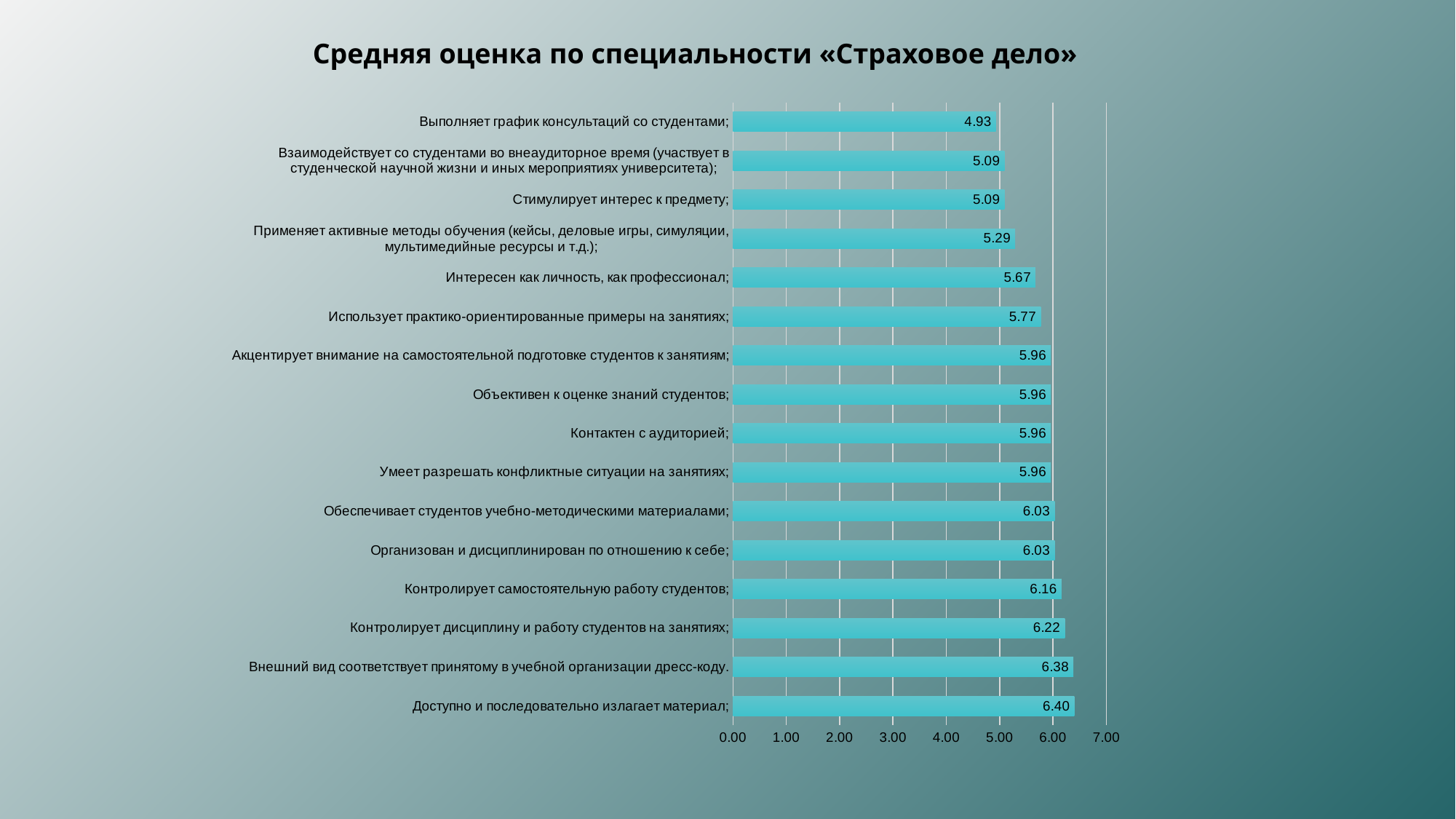
What type of chart is shown on the slide? Bar chart What is the value for «Контролирует дисциплину и работу студентов на занятиях»? 6.22 What is the title of the chart? Средняя оценка по специальности «Страховое дело» What is the value for «Интересен как личность, как профессионал»? 5.67 How many categories are plotted in the chart? 16 Is the value for «Применяет активные методы обучения» greater or less than 6.00? less Which is larger: the value for «Внешний вид соответствует принятому в учебной организации дресс-коду» or the value for «Контролирует самостоятельную работу студентов»? Внешний вид соответствует принятому в учебной организации дресс-коду What is the value for «Выполняет график консультаций со студентами»? 4.93 What is the difference between the highest value (6.40) and the lowest value (4.93)? 1.47 What is the value for «Доступно и последовательно излагает материал»? 6.40 Which category has the lowest value? Выполняет график консультаций со студентами Which category has the highest value? Доступно и последовательно излагает материал